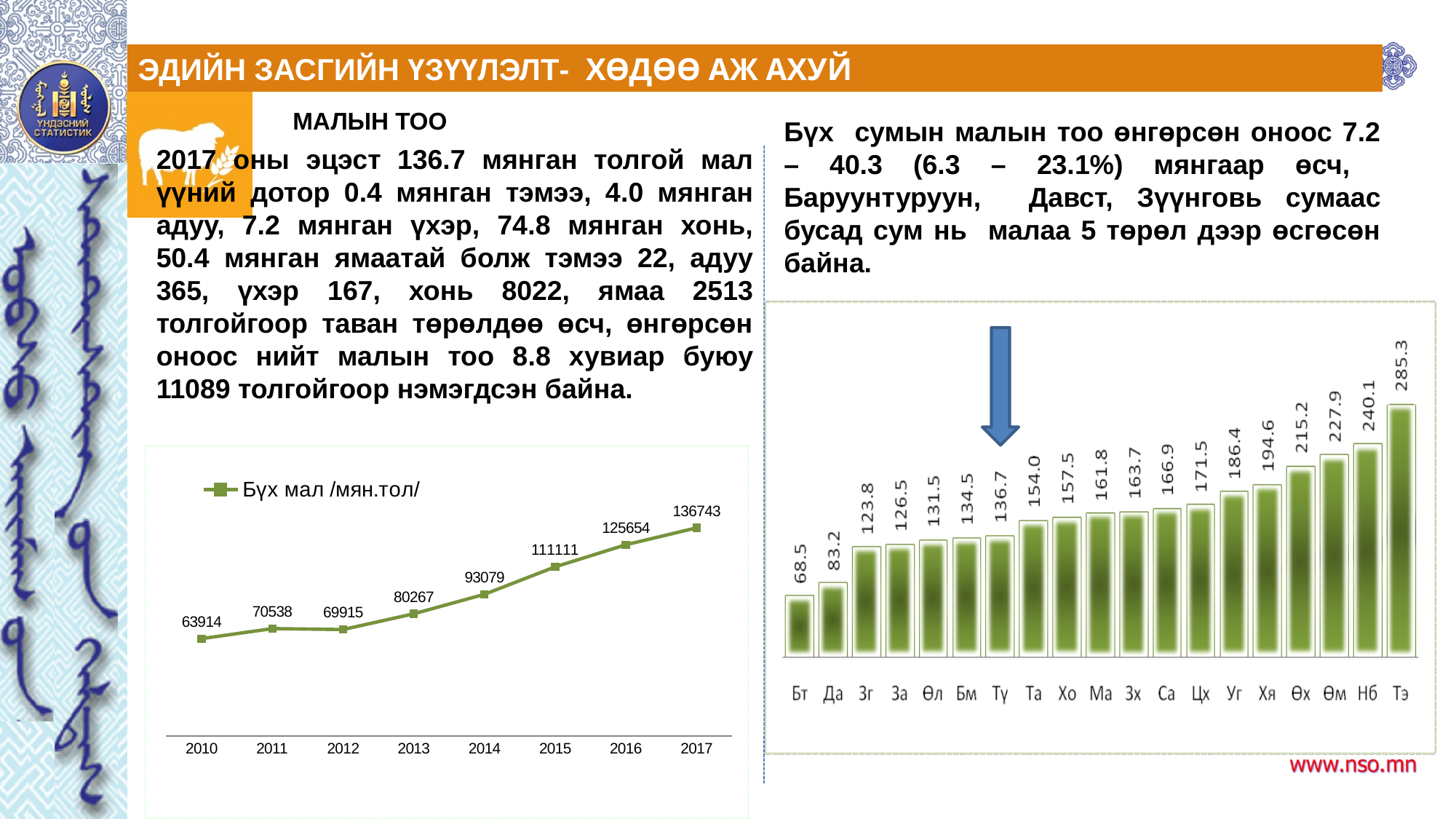
In the bar chart on the right, what is the difference between the values for Нб and Өм? 12.2 In the bar chart on the right, what is the value for Тэ? 285.3 In the bar chart on the right, which category has the lowest value? Бт In the line chart on the left, which is larger, the value for 2011 or the value for 2012? 2011 In the line chart on the left, what is the difference between the 2017 value and the 2016 value? 11089 In the line chart on the left, what is the name of the series shown in the legend? Бүх мал /мян.тол/ In the line chart on the left, how many years are plotted? 8 In the line chart on the left, what is the value for 2017? 136743 What type of chart is shown on the right side of the slide? bar chart In the line chart on the left, which year has the lowest value? 2010 In the line chart on the left, what is the value for 2010? 63914 In the bar chart on the right, how many categories are shown? 19